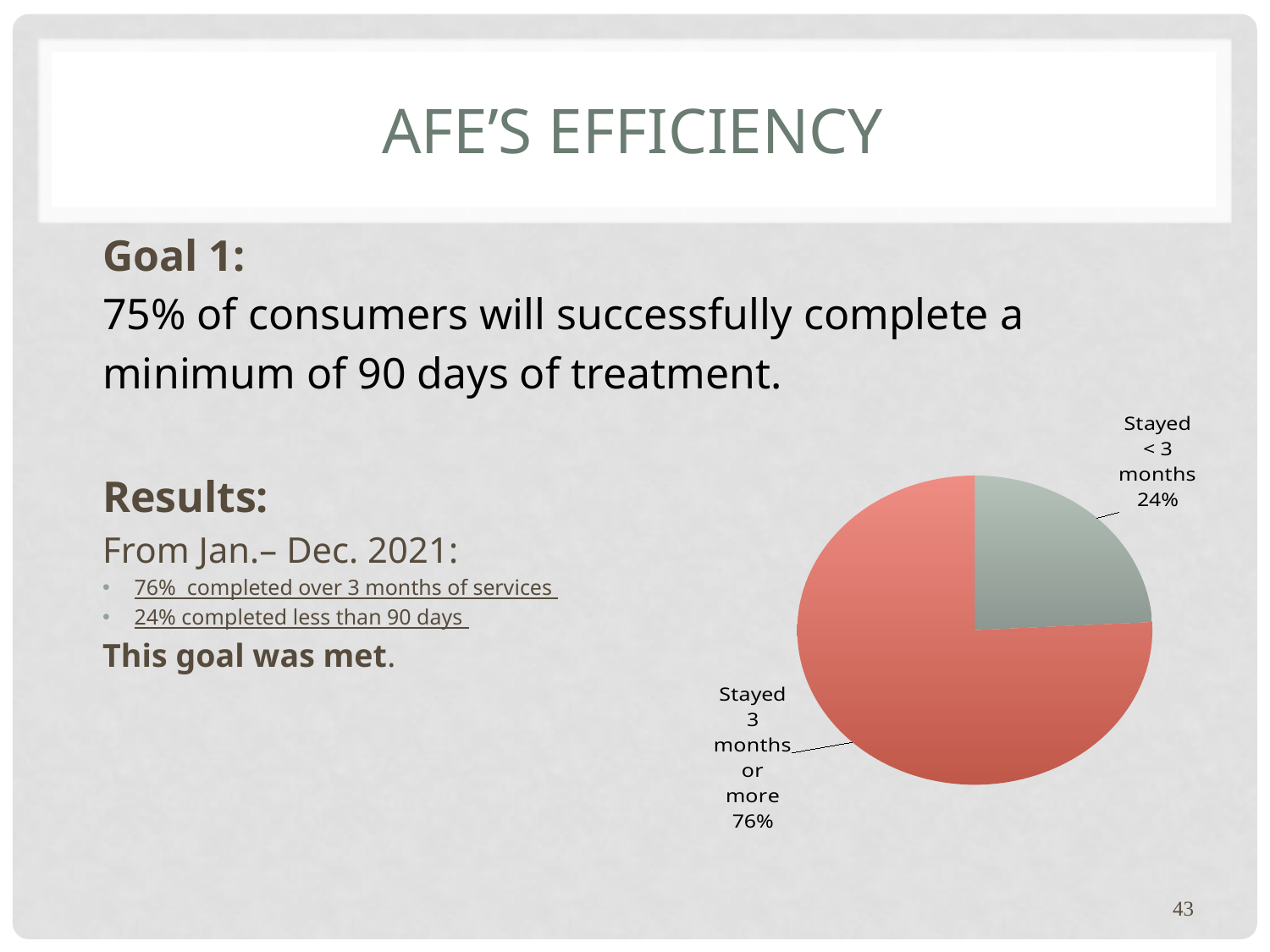
What share of the pie is labelled "Stayed 3 months or more"? 76% What colour is the "Stayed 3 months or more" slice? red Which is larger: the "Stayed < 3 months" slice or the "Stayed 3 months or more" slice? Stayed 3 months or more What is the difference in percentage points between the "Stayed 3 months or more" slice and the "Stayed < 3 months" slice? 52 What kind of chart is shown on the slide? pie chart Which slice of the pie chart is the largest? Stayed 3 months or more What is the total of the two slices shown in the pie chart? 100% What share of the pie is labelled "Stayed < 3 months"? 24% Which slice of the pie chart is the smallest? Stayed < 3 months How many slices does the pie chart have? 2 What colour is the "Stayed < 3 months" slice? grey-green